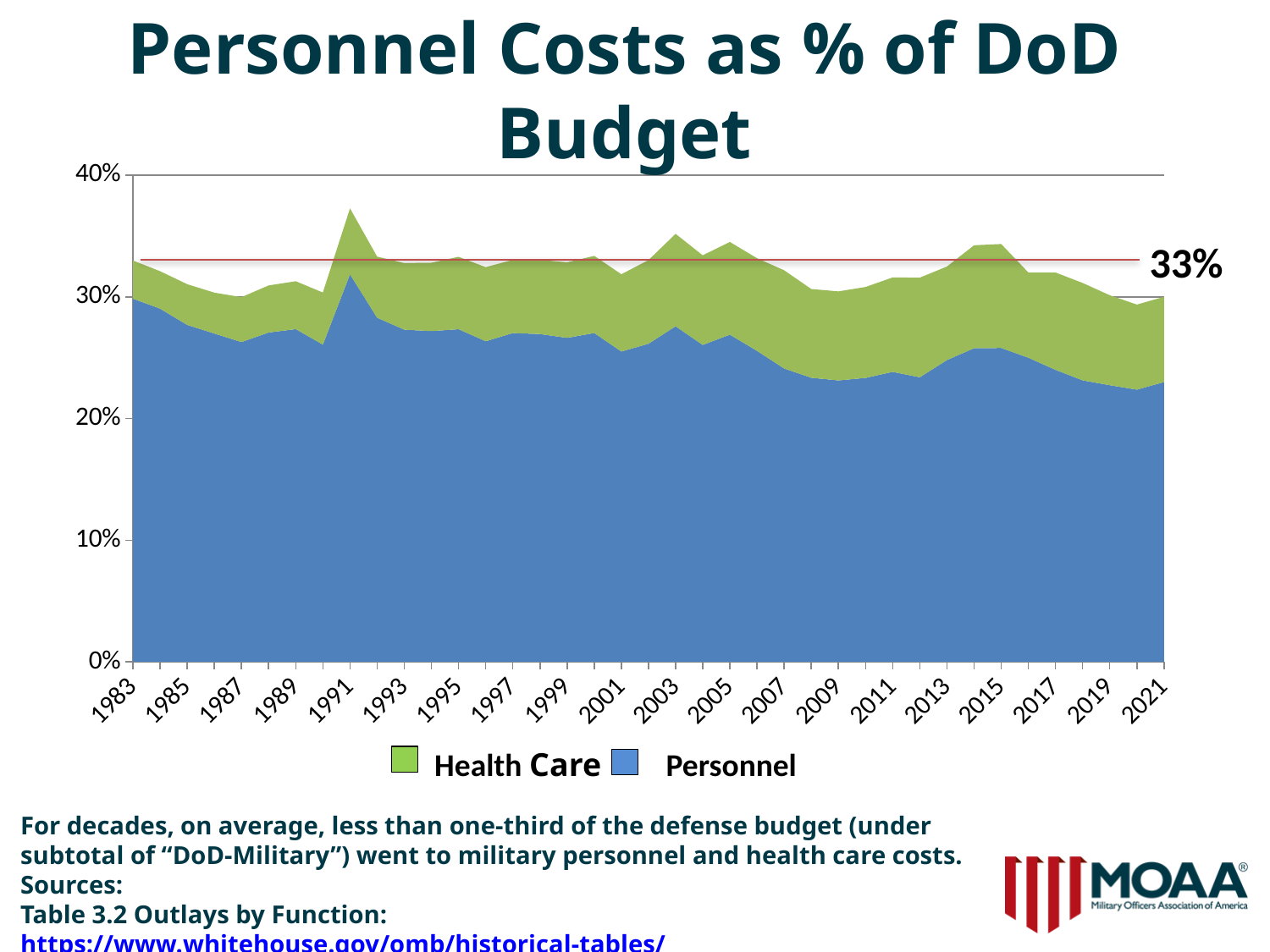
What is the title of the chart? Personnel Costs as % of DoD Budget Does the Personnel share generally rise or fall from 1983 to 2021? fall How many series does the legend list? 2 Which series is shown in green? Health Care Which series is larger in 2021, Personnel or Health Care? Personnel What kind of chart is shown on the slide? Stacked area chart Is the combined Personnel and Health Care total for 2009 greater or less than 33%? less What value is marked by the horizontal red reference line? 33% Is the Personnel value for 2009 greater or less than 30%? less Is the combined Personnel and Health Care total for 1991 greater or less than 33%? greater In which year does the combined Personnel and Health Care share reach its highest point? 1991